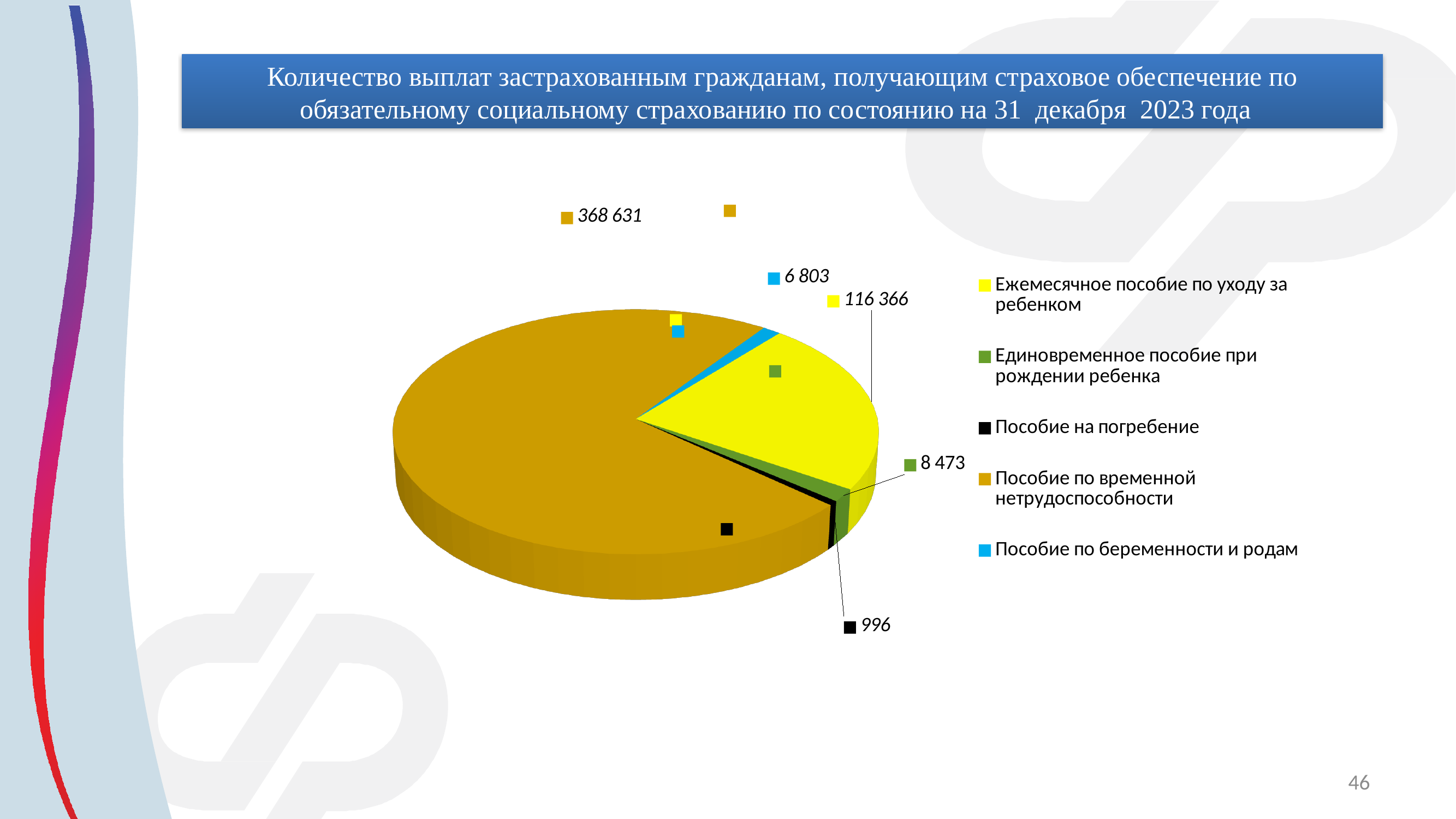
What is the difference between the values for "Пособие по временной нетрудоспособности" and "Ежемесячное пособие по уходу за ребенком"? 252 265 Which category has the smallest value in the pie chart? Пособие на погребение What colour is the slice for "Пособие по беременности и родам"? Blue How many categories does the pie chart show? 5 Which category has the largest value in the pie chart? Пособие по временной нетрудоспособности Which is larger: the value for "Единовременное пособие при рождении ребенка" or for "Пособие по беременности и родам"? Единовременное пособие при рождении ребенка What is the value for "Ежемесячное пособие по уходу за ребенком"? 116 366 What type of chart is shown on the slide? Pie chart What is the value for "Пособие по беременности и родам"? 6 803 What is the value for "Пособие по временной нетрудоспособности"? 368 631 What is the value for "Пособие на погребение"? 996 What is the value for "Единовременное пособие при рождении ребенка"? 8 473